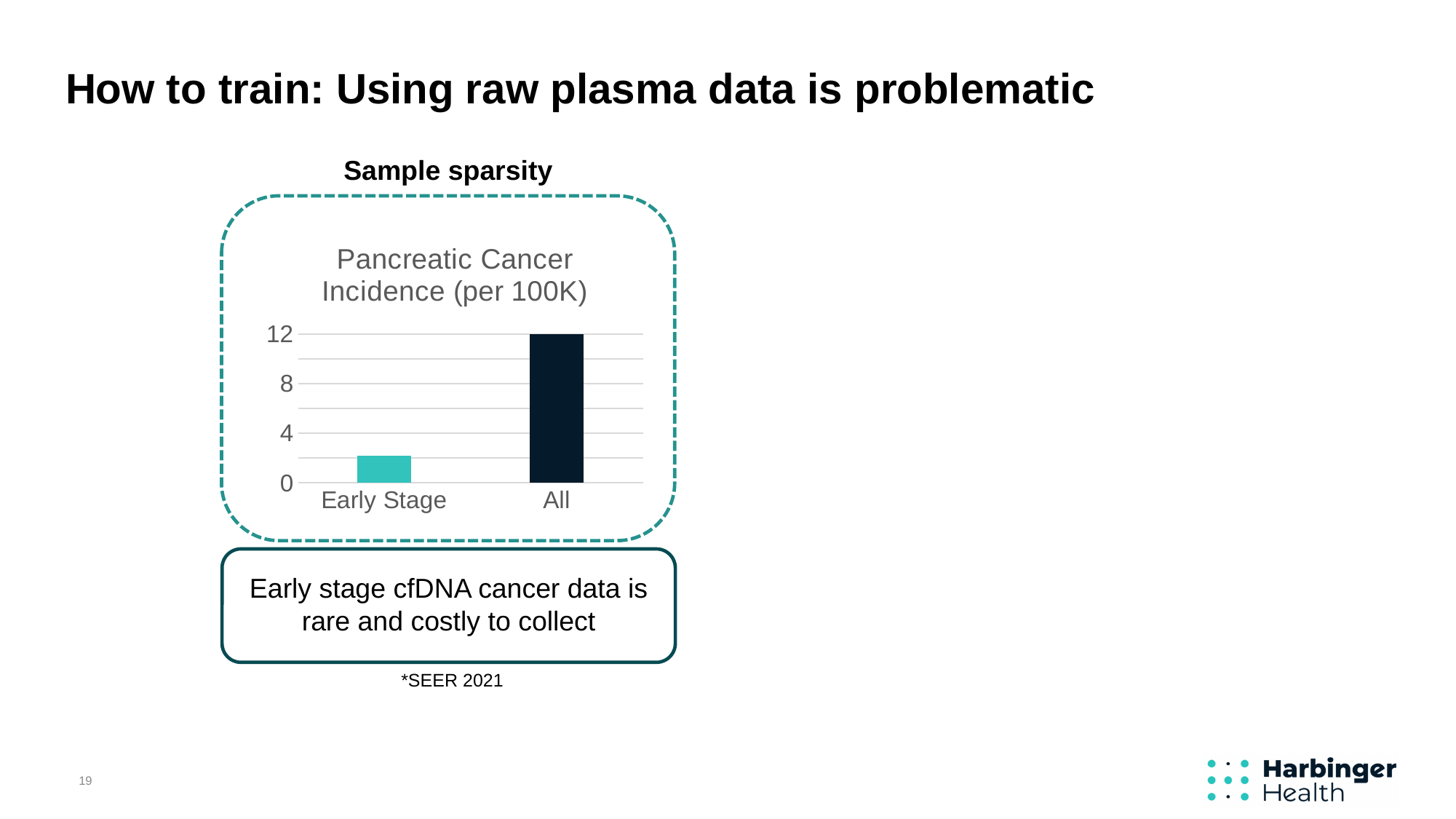
Which category has the highest pancreatic cancer incidence? All Is the value for Early Stage greater or less than 4? less Is the value for All greater or less than 8? greater Which is larger, the value for Early Stage or the value for All? All What is the title of the chart? Pancreatic Cancer Incidence (per 100K) What kind of chart is shown on the slide? bar chart Is the value for Early Stage greater or less than 8? less What colour is the Early Stage bar? teal Which category has the lowest pancreatic cancer incidence? Early Stage How many categories are plotted in the chart? 2 What is the pancreatic cancer incidence per 100K for All? 12